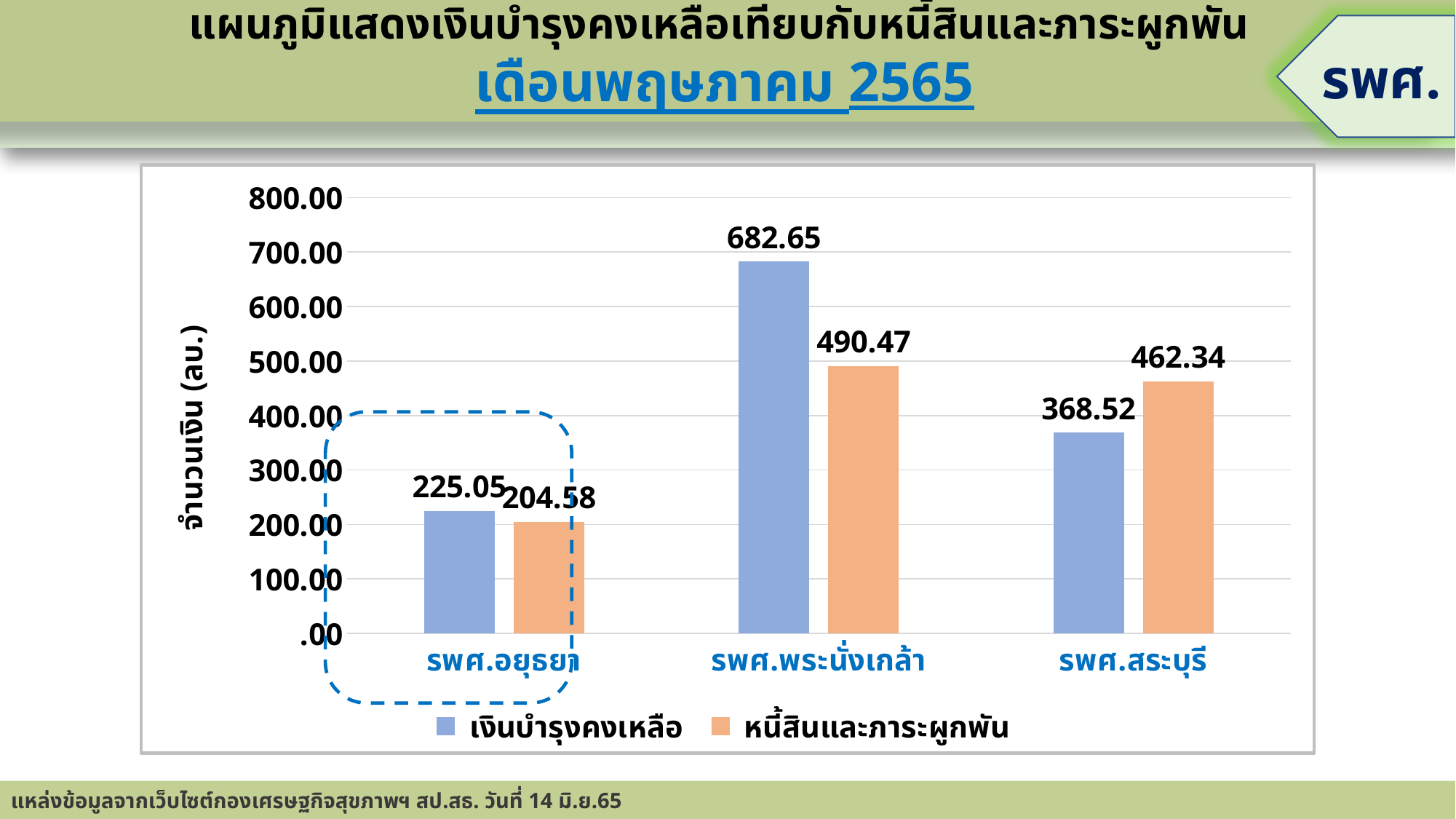
What is the value of เงินบำรุงคงเหลือ for รพศ.พระนั่งเกล้า? 682.65 What is the value of หนี้สินและภาระผูกพัน for รพศ.อยุธยา? 204.58 What is the difference between หนี้สินและภาระผูกพัน and เงินบำรุงคงเหลือ for รพศ.สระบุรี? 93.82 What is the value of หนี้สินและภาระผูกพัน for รพศ.สระบุรี? 462.34 For รพศ.สระบุรี, which is larger: เงินบำรุงคงเหลือ or หนี้สินและภาระผูกพัน? หนี้สินและภาระผูกพัน What is the label of the y axis? จำนวนเงิน (ลบ.) How many hospitals are shown on the x axis of the chart? 3 What kind of chart is shown on the slide? Bar chart How many series does the legend list? 2 What is the difference between เงินบำรุงคงเหลือ and หนี้สินและภาระผูกพัน for รพศ.พระนั่งเกล้า? 192.18 Which hospital has the highest เงินบำรุงคงเหลือ? รพศ.พระนั่งเกล้า Which hospital has the lowest หนี้สินและภาระผูกพัน? รพศ.อยุธยา